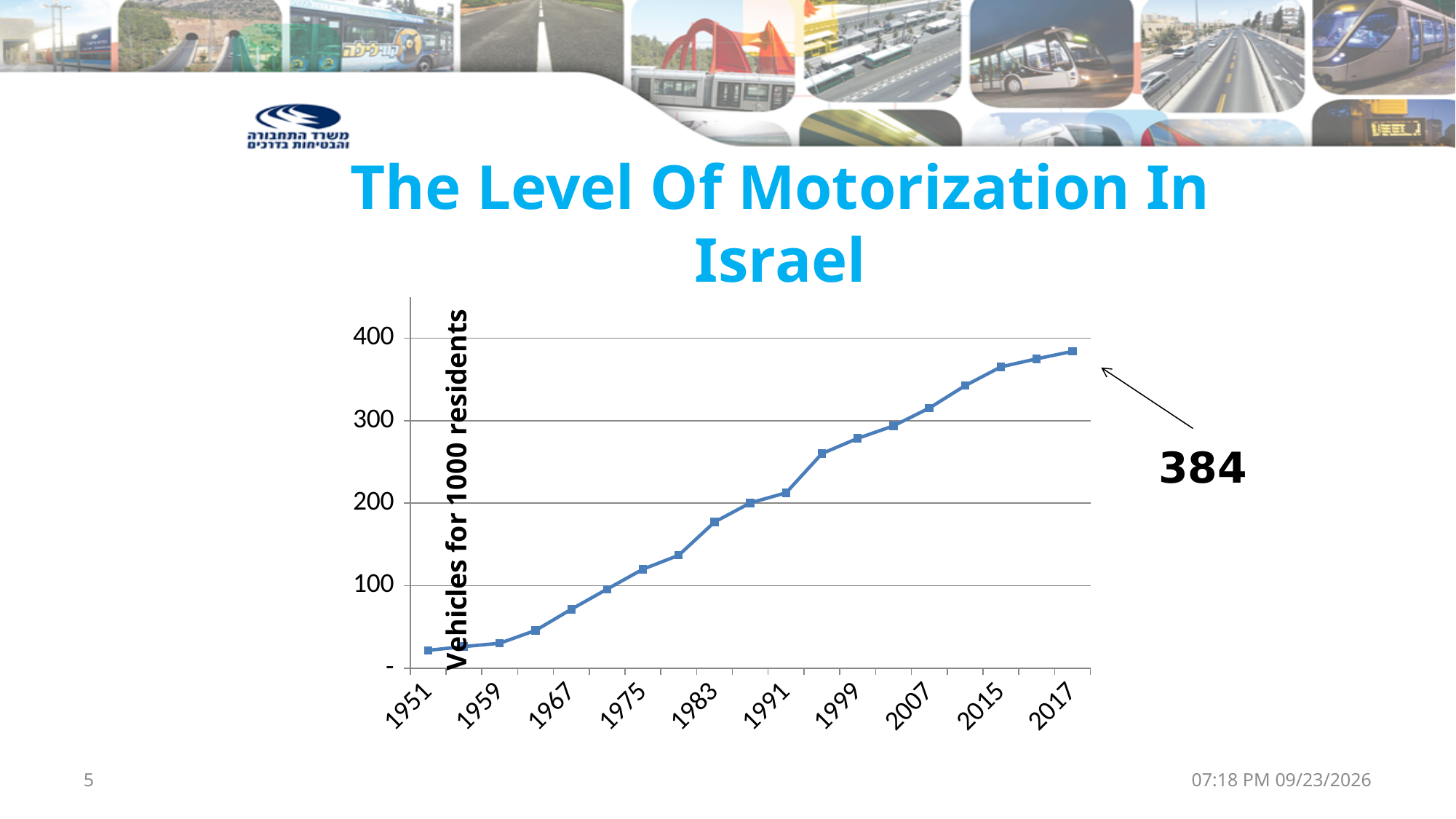
What is the label on the vertical axis of the chart? Vehicles for 1000 residents Is the value for 1951 greater or less than 100? less Which year has the lowest value on the chart? 1951 Which year has the highest value on the chart? 2017 Is the value for 1999 greater or less than 200? greater How many year labels are shown on the x axis? 10 Is the value for 1967 greater or less than 100? less Which year has the larger value, 1983 or 2007? 2007 Do the values rise or fall from 1951 to 2017? rise What kind of chart is shown on the slide? line chart What is the value of vehicles per 1000 residents for 2017? 384